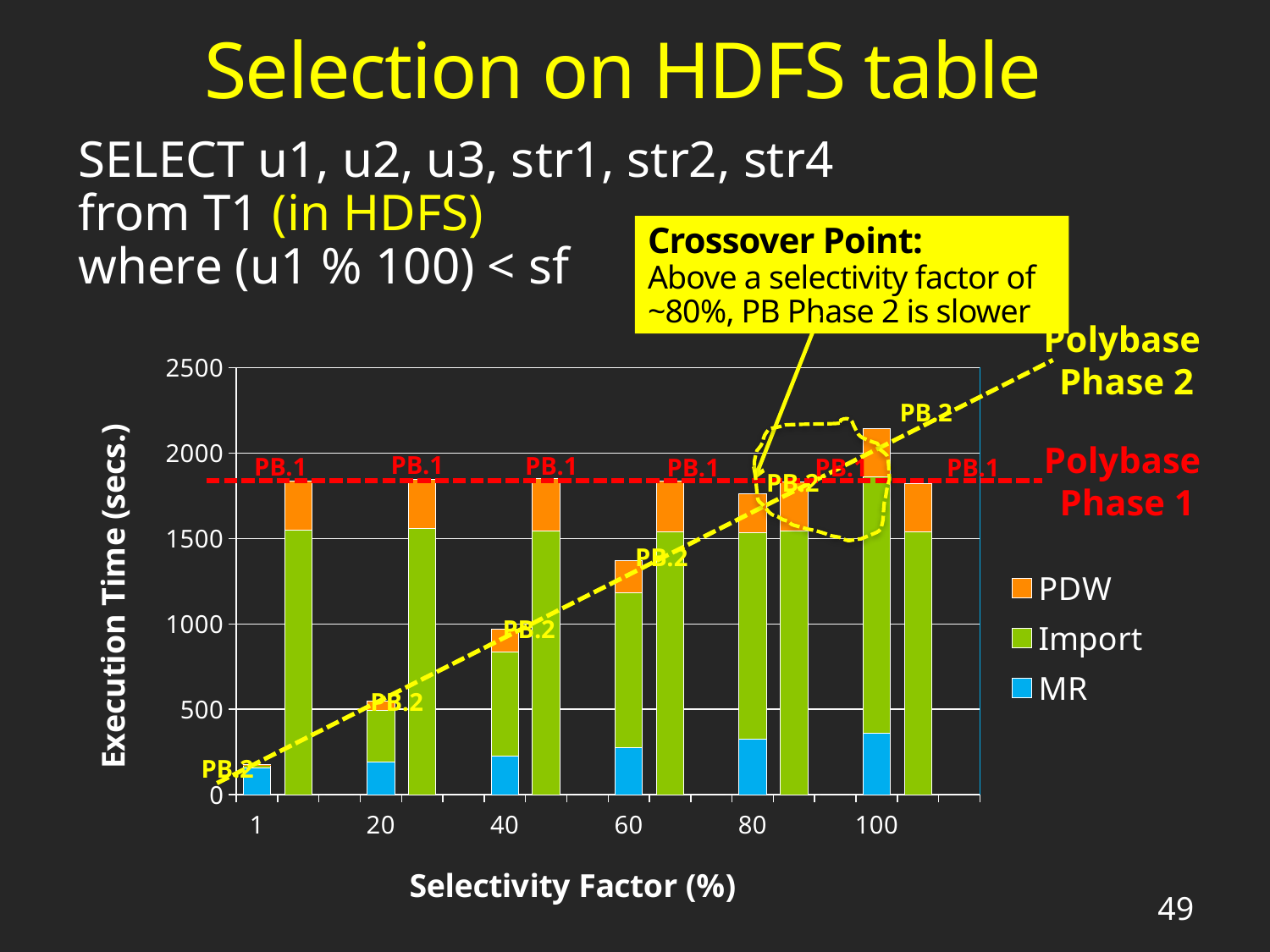
At which selectivity factor is the PB.2 bar the shortest? 1 At which selectivity factor is the PB.2 bar the tallest? 100 Which series are listed in the chart legend? PDW, Import, MR Is the total execution time of the PB.1 bar at selectivity factor 1 greater or less than 2000? less How many series does the chart legend list? 3 What is the title of the y axis? Execution Time (secs.) Do the PB.2 (Polybase Phase 2) bars rise or fall as the selectivity factor increases? rise What kind of chart is shown on the slide? Stacked bar chart Is the total execution time of the PB.2 bar at selectivity factor 60 greater or less than 1000? greater Is the total execution time of the PB.2 bar at selectivity factor 100 greater or less than 2000? greater How many selectivity factor values are shown on the x axis? 6